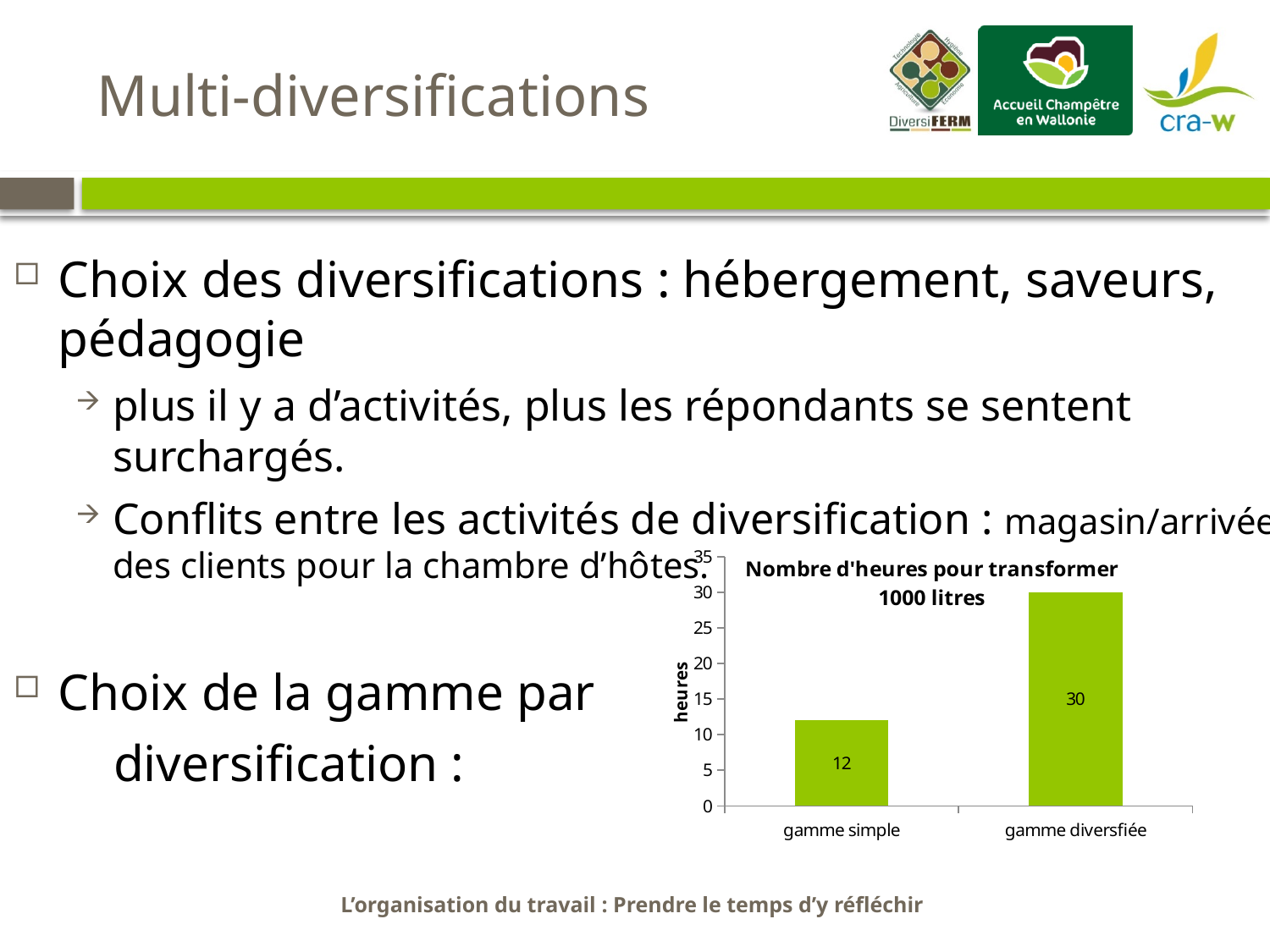
What is the value for gamme simple? 12 How many categories are shown on the x axis? 2 What is the difference between the values for gamme diversfiée and gamme simple? 18 Which category has the lowest value? gamme simple What is the value for gamme diversfiée? 30 What is the title of the chart? Nombre d'heures pour transformer 1000 litres What is the label of the y axis? heures Which category has the highest value? gamme diversfiée What kind of chart is shown? bar chart Is the value for gamme diversfiée greater or less than 25? greater Which is larger, the value for gamme simple or the value for gamme diversfiée? gamme diversfiée Is the value for gamme simple greater or less than 15? less